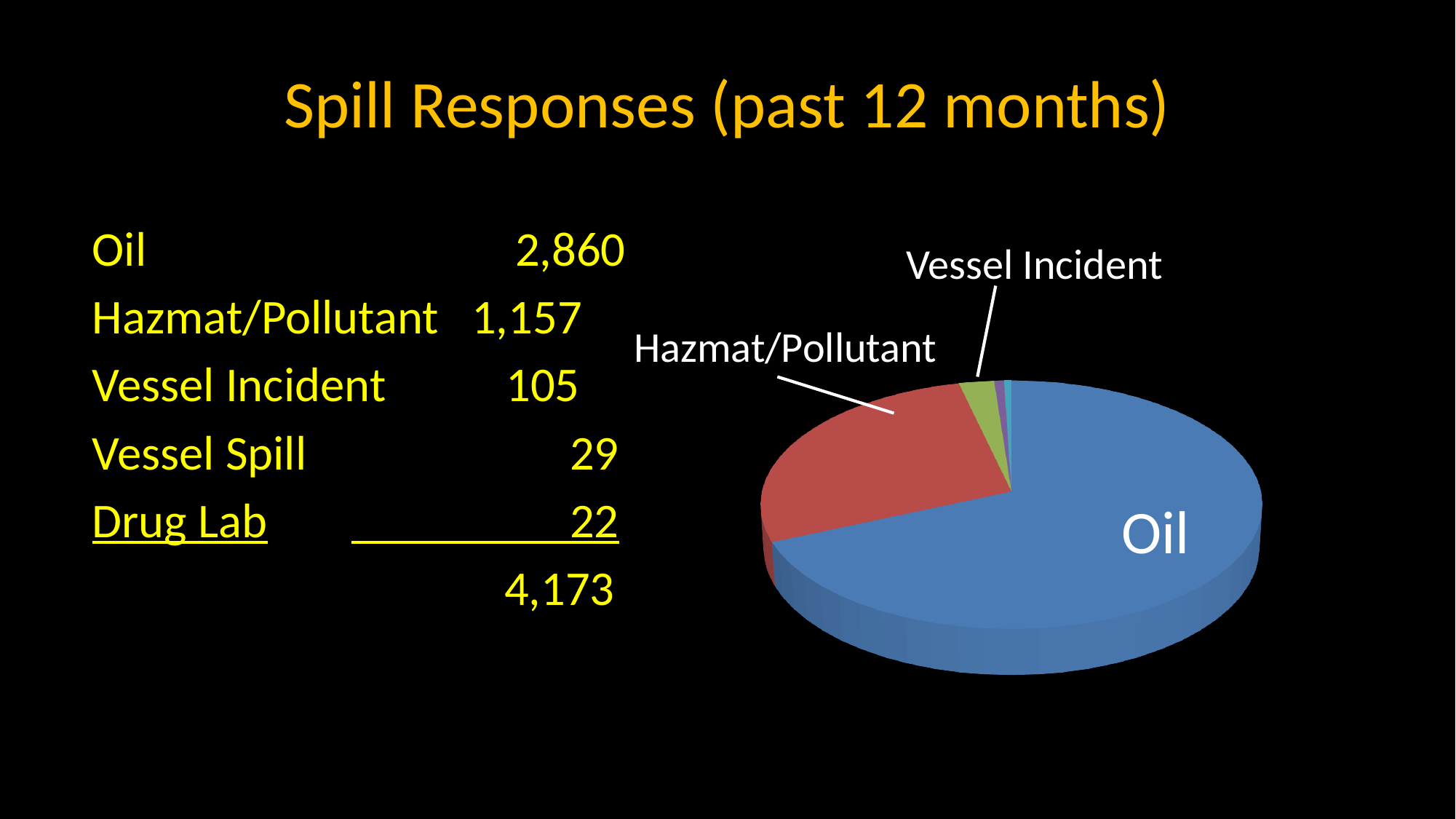
How many spill responses were for Vessel Incident? 105 How many spill responses were for Drug Lab? 22 Which category has the smallest number of spill responses? Drug Lab What is the title of the slide? Spill Responses (past 12 months) Which had more responses, Vessel Incident or Vessel Spill? Vessel Incident What is the total number of spill responses across all categories? 4,173 What is the difference between the Oil and Hazmat/Pollutant response counts? 1,703 How many spill responses were for Oil? 2,860 How many spill responses were for Hazmat/Pollutant? 1,157 What kind of chart is shown on the slide? pie chart Which category has the largest slice of the pie? Oil How many categories of spill responses are listed? 5